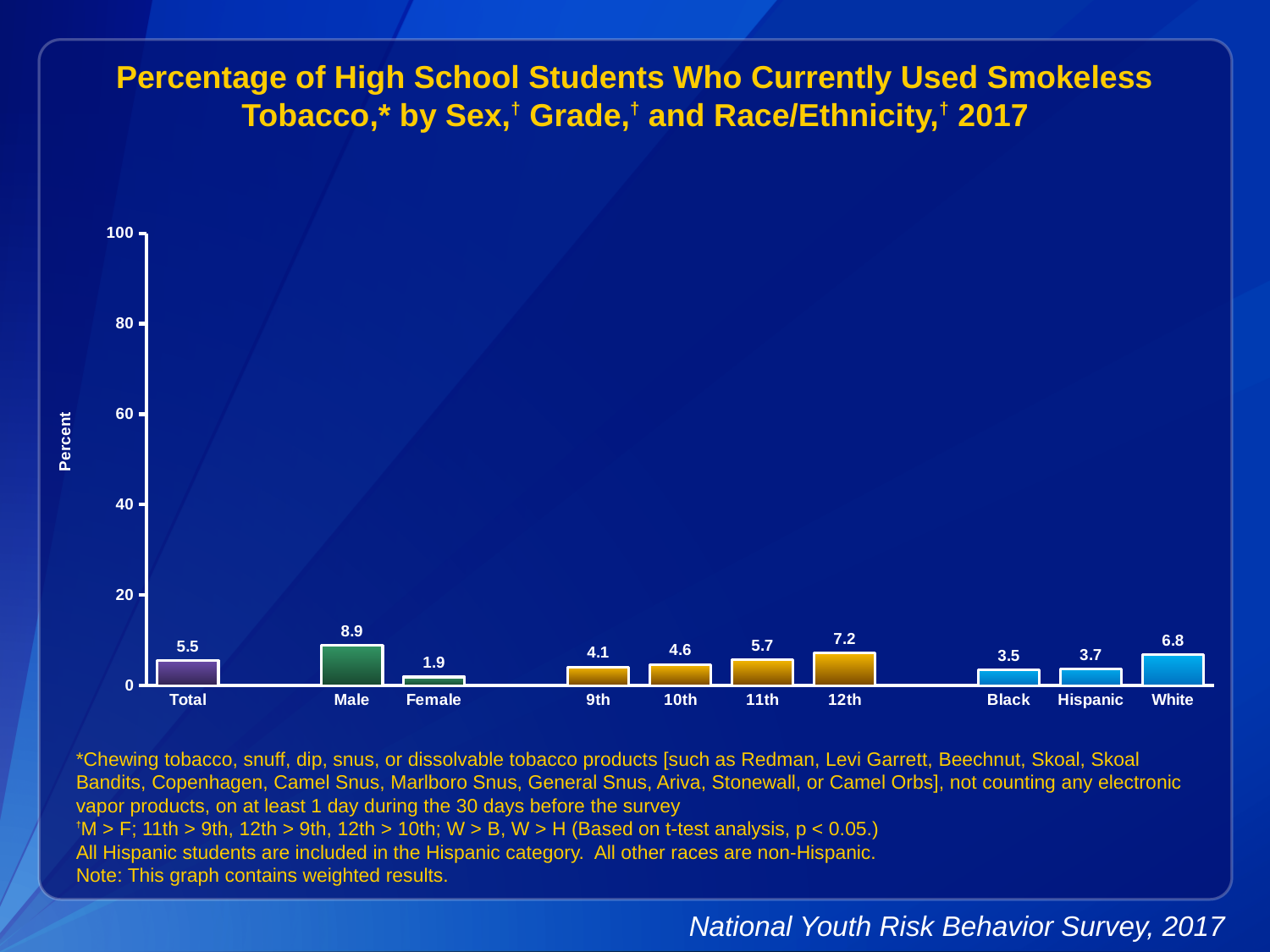
How many categories are shown on the x axis? 10 Which category has the lowest value? Female Which is larger, the value for 11th grade or the value for 9th grade? 11th What kind of chart is this? Bar chart What is the value for 12th grade? 7.2 What is the value for Male? 8.9 What is the difference between the values for White and Black? 3.3 Is the value for Total greater or less than 20? less What is the value for Female? 1.9 Which category has the highest value? Male What is the difference between the values for Male and Female? 7.0 What is the value for Hispanic students? 3.7